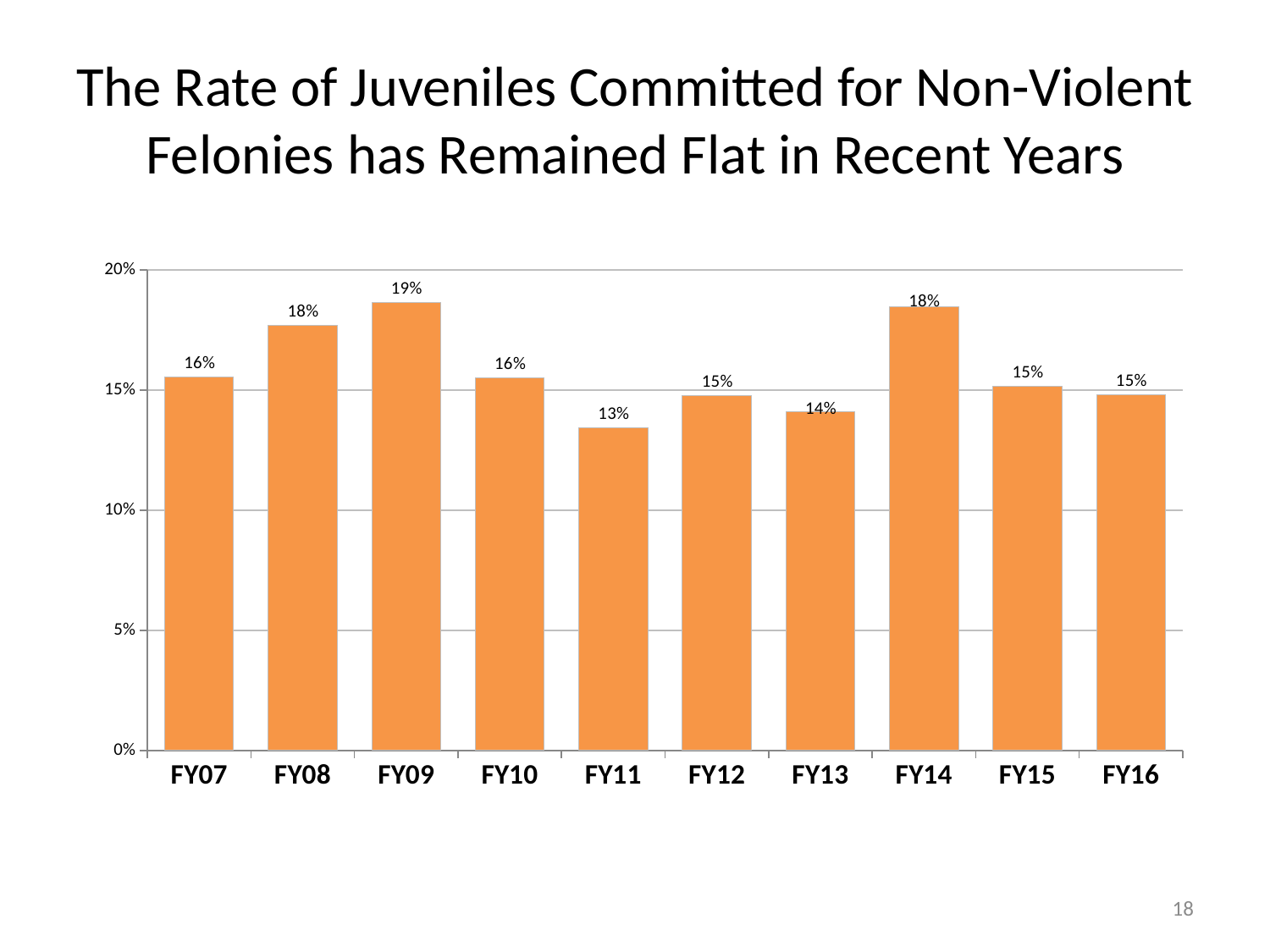
What kind of chart is shown on the slide? bar chart Do the values rise or fall from FY09 to FY11? fall Which fiscal year has the highest rate? FY09 Which fiscal year has the lowest rate? FY11 What is the value for FY14? 18% What is the value for FY11? 13% Which is larger, the value for FY08 or the value for FY13? FY08 How many fiscal years are shown on the x axis? 10 What is the difference between the values for FY09 and FY11? 6 percentage points Is the value for FY11 greater or less than 15%? less What is the value for FY16? 15% What is the value for FY09? 19%